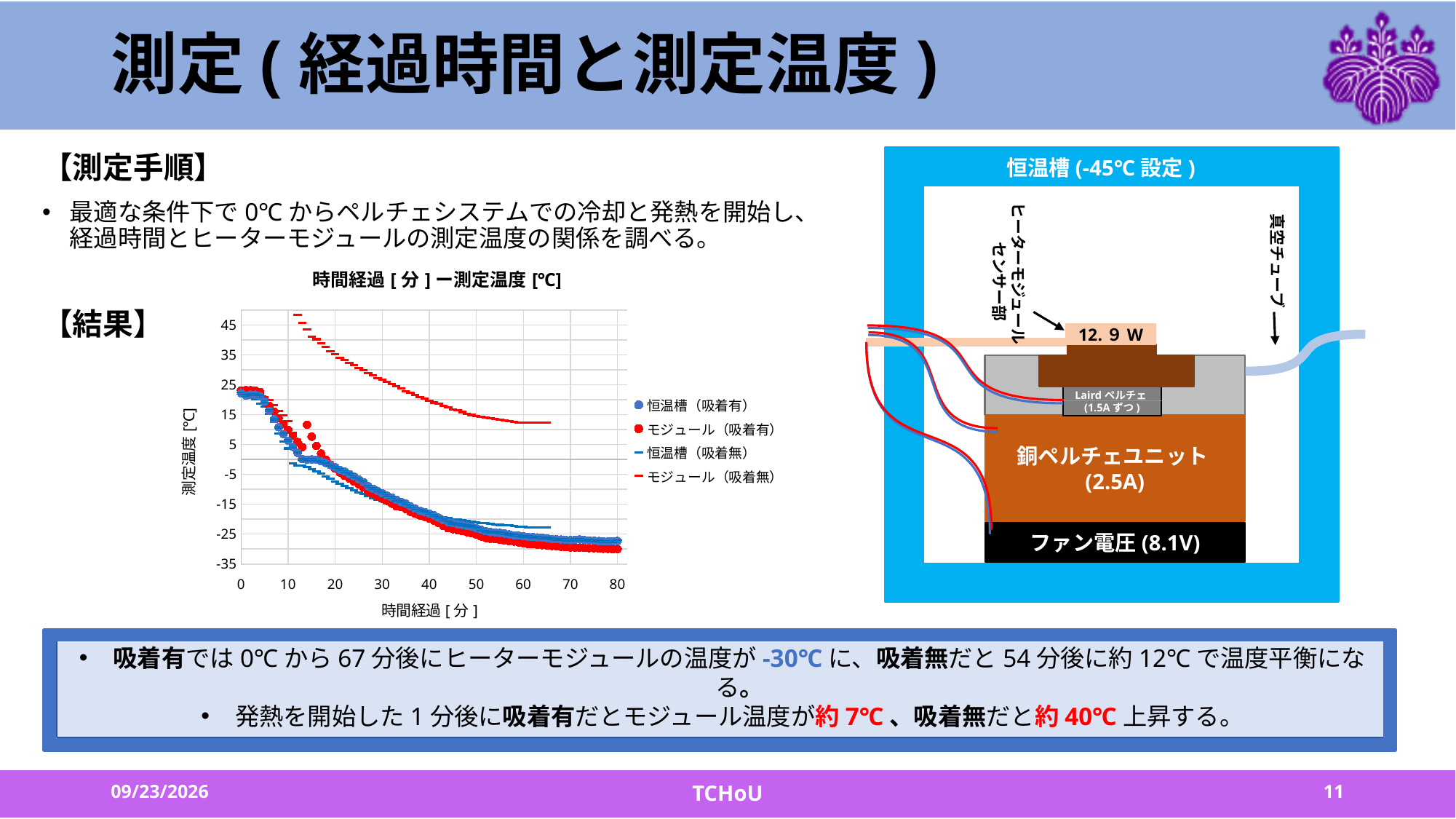
Is the value for モジュール（吸着無） at 10 minutes greater or less than 35? less How many series does the chart legend list? 4 Do the values for 恒温槽（吸着有） rise or fall as elapsed time increases? fall What is the title of the chart? 時間経過 [ 分 ] ー測定温度 [℃] Is the value for モジュール（吸着有） at 80 minutes greater or less than -25? less Which series reaches the highest temperature on the chart? モジュール（吸着無） What is the label of the chart's vertical axis? 測定温度 [℃] At 60 minutes, which is larger: the value for モジュール（吸着無） or the value for モジュール（吸着有）? モジュール（吸着無） Is the value for 恒温槽（吸着無） at 60 minutes greater or less than -15? less What kind of chart is shown on the slide? scatter chart